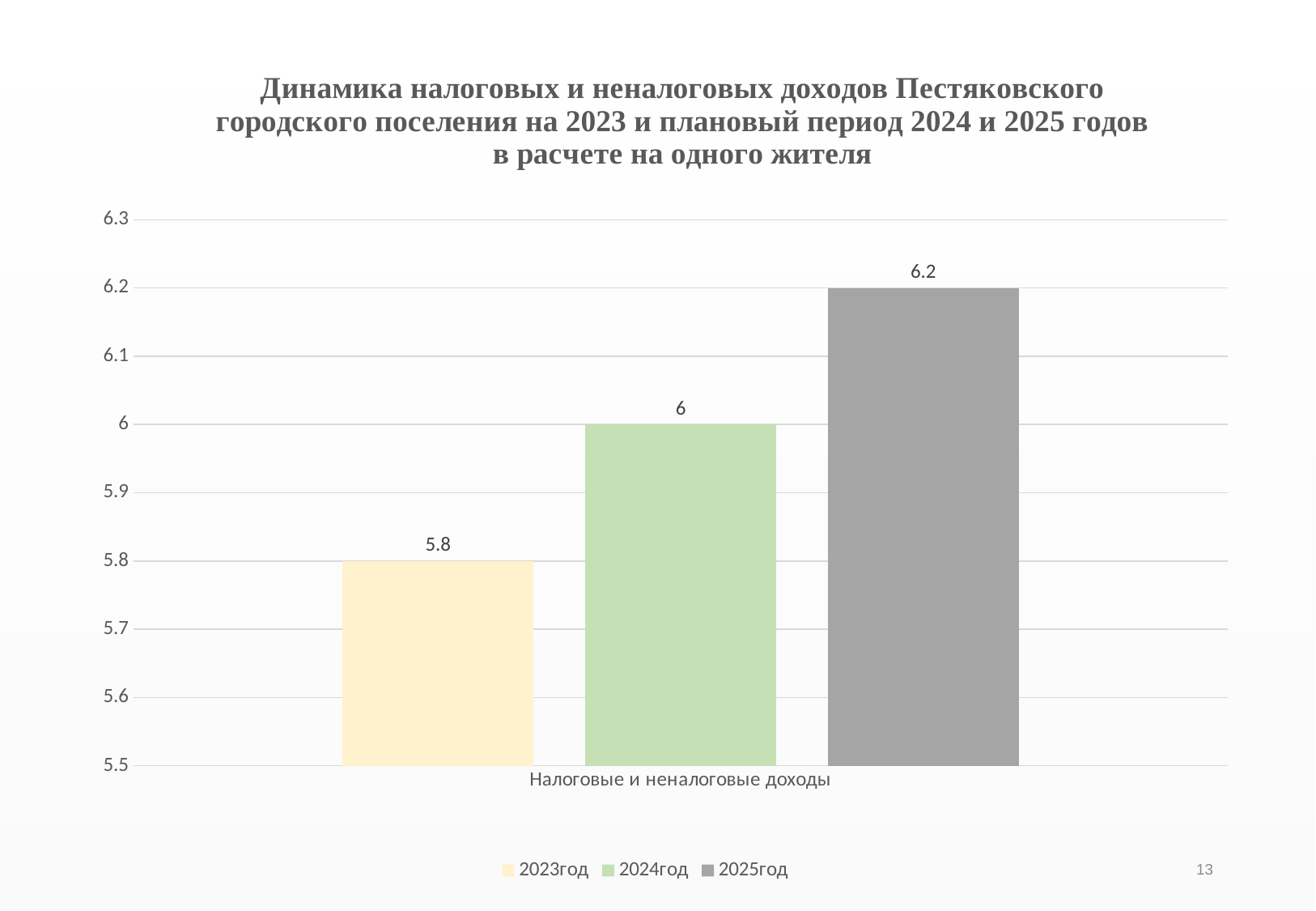
What is the value for 2023год? 5.8 Which year has the highest value? 2025год Which is larger, the value for 2024год or the value for 2025год? 2025год What is the difference between the values for 2024год and 2023год? 0.2 Is the value for 2023год greater or less than 6? less What is the value for 2024год? 6 What is the difference between the values for 2025год and 2023год? 0.4 Do the values rise or fall from 2023год to 2025год? rise Which year has the lowest value? 2023год What kind of chart is shown on the slide? bar chart What is the value for 2025год? 6.2 How many series does the legend list? 3